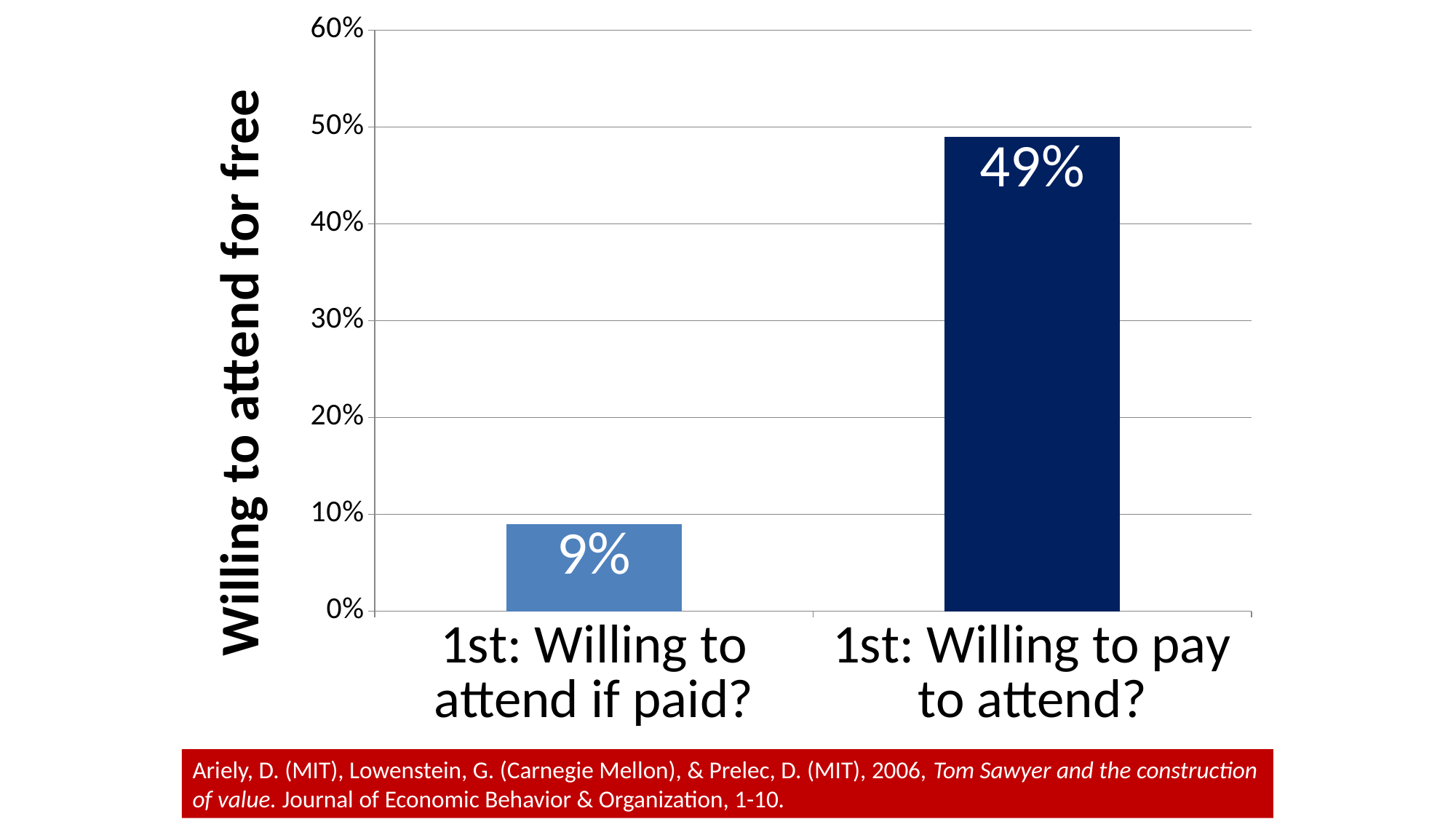
What is the value for "1st: Willing to attend if paid?"? 9% Which category has the highest value? 1st: Willing to pay to attend? What is the highest value shown on the vertical axis? 60% Is the value for "1st: Willing to pay to attend?" greater or less than 40%? greater Is the value for "1st: Willing to attend if paid?" greater or less than 10%? less What is the label of the vertical axis? Willing to attend for free Which is larger: the value for "1st: Willing to attend if paid?" or the value for "1st: Willing to pay to attend?"? 1st: Willing to pay to attend? Which category has the lowest value? 1st: Willing to attend if paid? What is the value for "1st: Willing to pay to attend?"? 49% How many categories are shown on the chart? 2 What kind of chart is shown on the slide? Bar chart What is the difference between the values for "1st: Willing to pay to attend?" and "1st: Willing to attend if paid?"? 40%